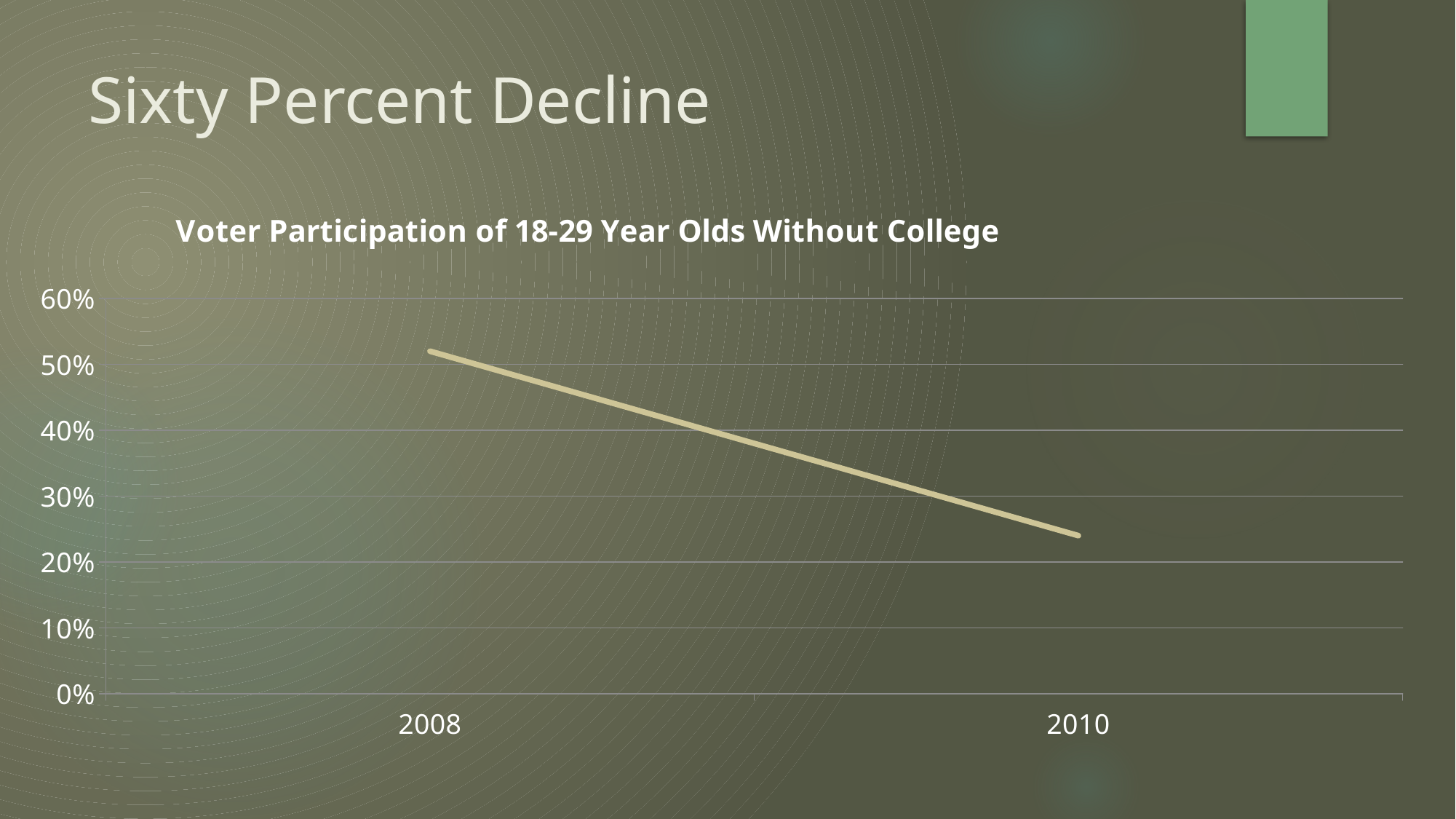
How many data points are plotted on the chart? 2 Is the value for 2010 greater or less than 30%? less Which year has the higher voter participation, 2008 or 2010? 2008 Is the value for 2008 greater or less than 40%? greater What is the title of the chart? Voter Participation of 18-29 Year Olds Without College Which year has the highest voter participation on the chart? 2008 Which years are shown on the x axis of the chart? 2008 and 2010 Is the value for 2010 greater or less than 20%? greater Which year has the lowest voter participation on the chart? 2010 Does voter participation rise or fall from 2008 to 2010? fall What kind of chart is shown on the slide? line chart